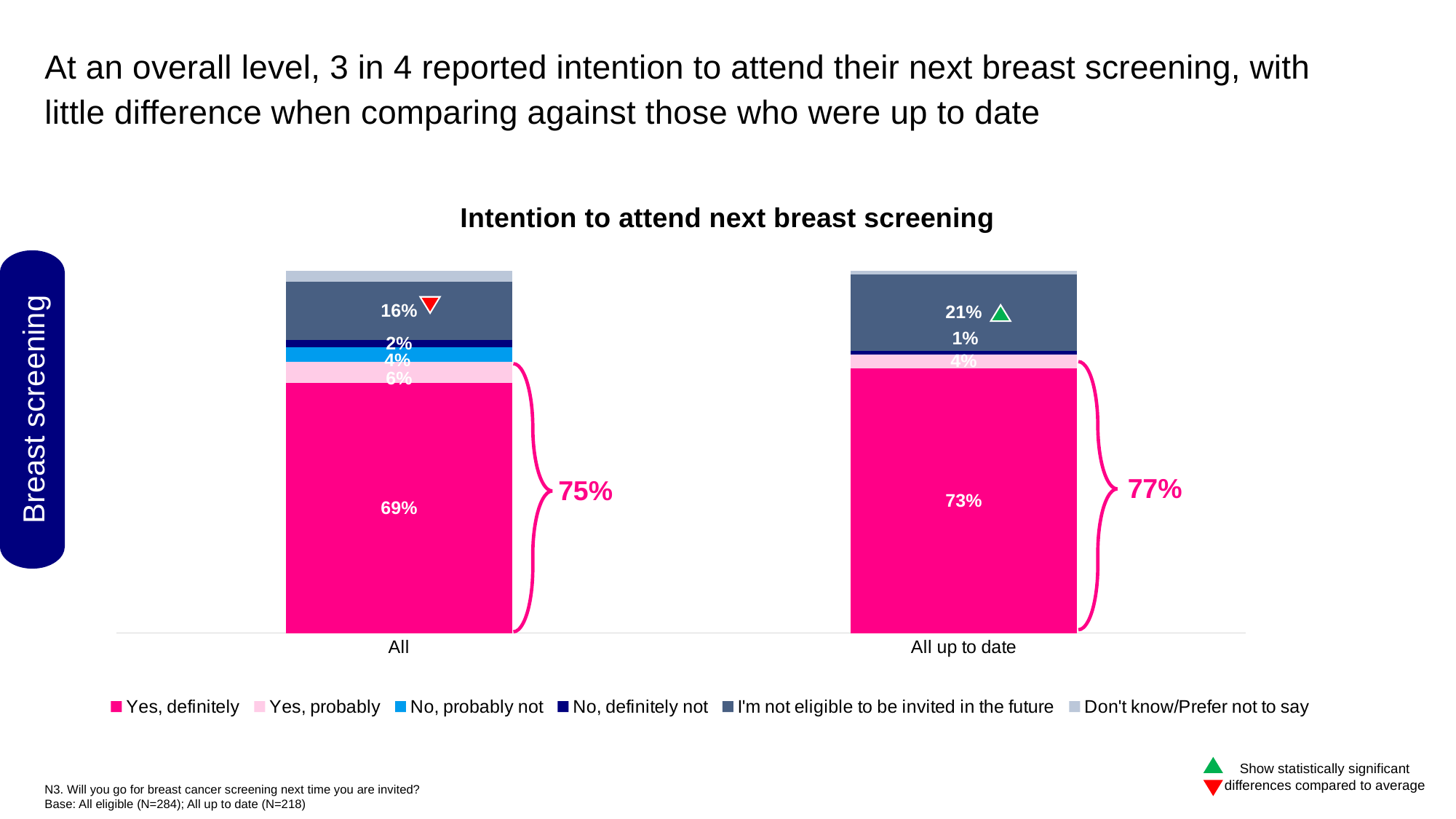
What percentage of the 'All up to date' group said they are not eligible to be invited in the future? 21% How many series does the legend list? 6 How many categories (bars) are shown on the x axis? 2 What percentage of the 'All' group answered 'Yes, probably'? 6% Which group has the higher 'Yes, definitely' share, 'All' or 'All up to date'? All up to date What percentage of the 'All' group said they are not eligible to be invited in the future? 16% What is the difference in the 'Yes, definitely' share between 'All up to date' and 'All'? 4 percentage points What percentage of the 'All up to date' group answered 'Yes, definitely'? 73% What combined 'Yes' percentage is shown by the bracket next to the 'All' bar? 75% What is the title of the chart? Intention to attend next breast screening What kind of chart is shown on the slide? Stacked bar chart What percentage of the 'All' group answered 'Yes, definitely'? 69%